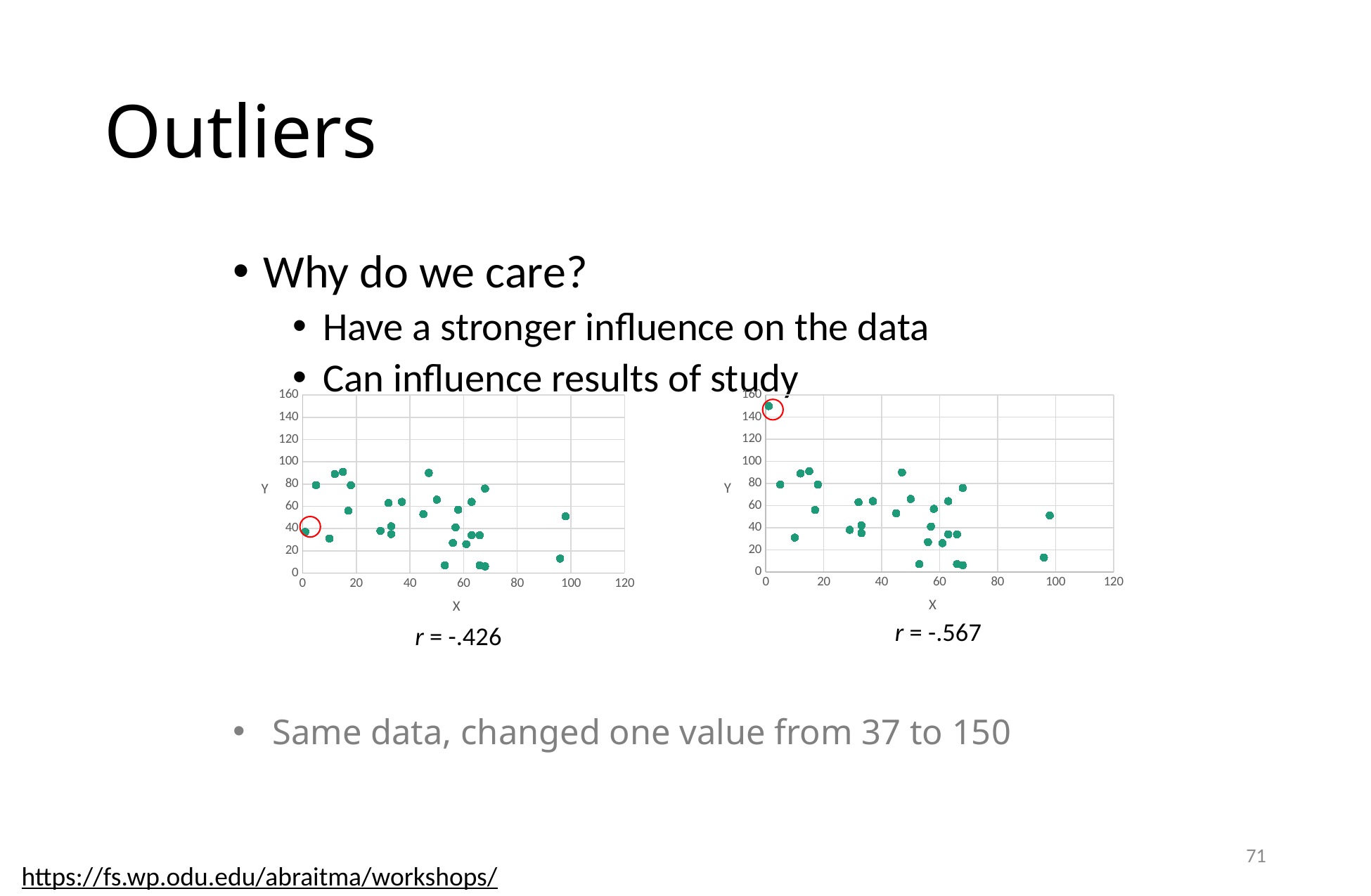
What kind of chart is the left chart on the slide? scatter plot What is the highest tick value shown on the X axis of the right chart? 120 In the right chart, do the Y values generally rise or fall as X increases? fall In the left chart, is the highest Y value plotted greater or less than 100? less In the left chart, is the Y value of the circled point greater or less than 60? less What is the highest tick value shown on the Y axis of the left chart? 160 In the right chart, is the highest Y value plotted greater or less than 120? greater What kind of chart is the right chart on the slide? scatter plot